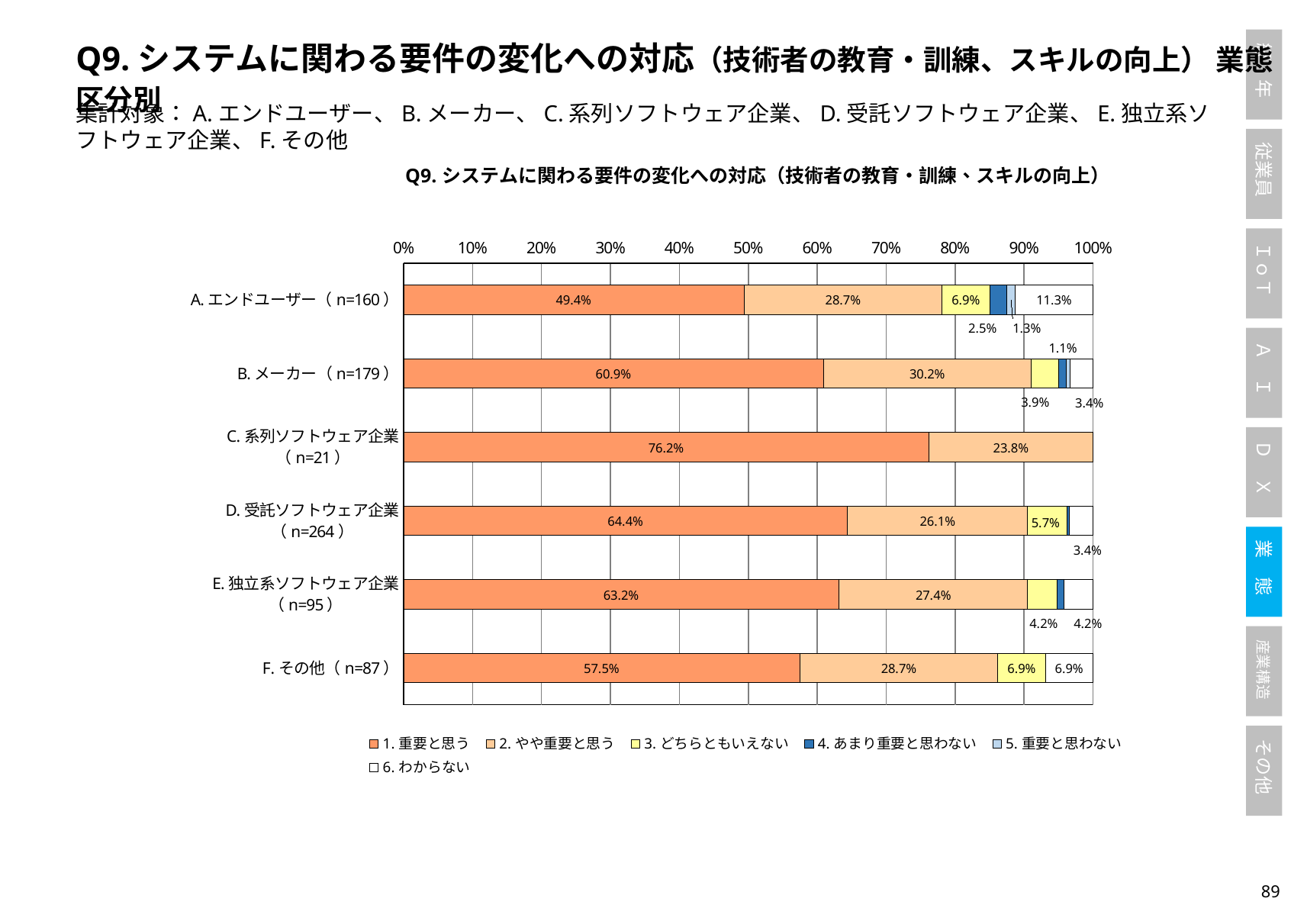
How many series does the legend list? 6 What is the difference between the 「1. 重要と思う」 values for C. 系列ソフトウェア企業 and A. エンドユーザー? 26.8% Which has a larger 「1. 重要と思う」 value, D. 受託ソフトウェア企業 or E. 独立系ソフトウェア企業? D. 受託ソフトウェア企業 What kind of chart is shown on the slide? Stacked bar chart What is the value of 「1. 重要と思う」 for C. 系列ソフトウェア企業 (n=21)? 76.2% How many categories (業態区分) are plotted on the chart? 6 What is the value of 「2. やや重要と思う」 for B. メーカー (n=179)? 30.2% What is the value of 「1. 重要と思う」 for A. エンドユーザー (n=160)? 49.4% What is the value of 「6. わからない」 for A. エンドユーザー (n=160)? 11.3% Which category has the highest value for 「1. 重要と思う」? C. 系列ソフトウェア企業 Which category has the lowest value for 「1. 重要と思う」? A. エンドユーザー What is the value of 「3. どちらともいえない」 for D. 受託ソフトウェア企業 (n=264)? 5.7%